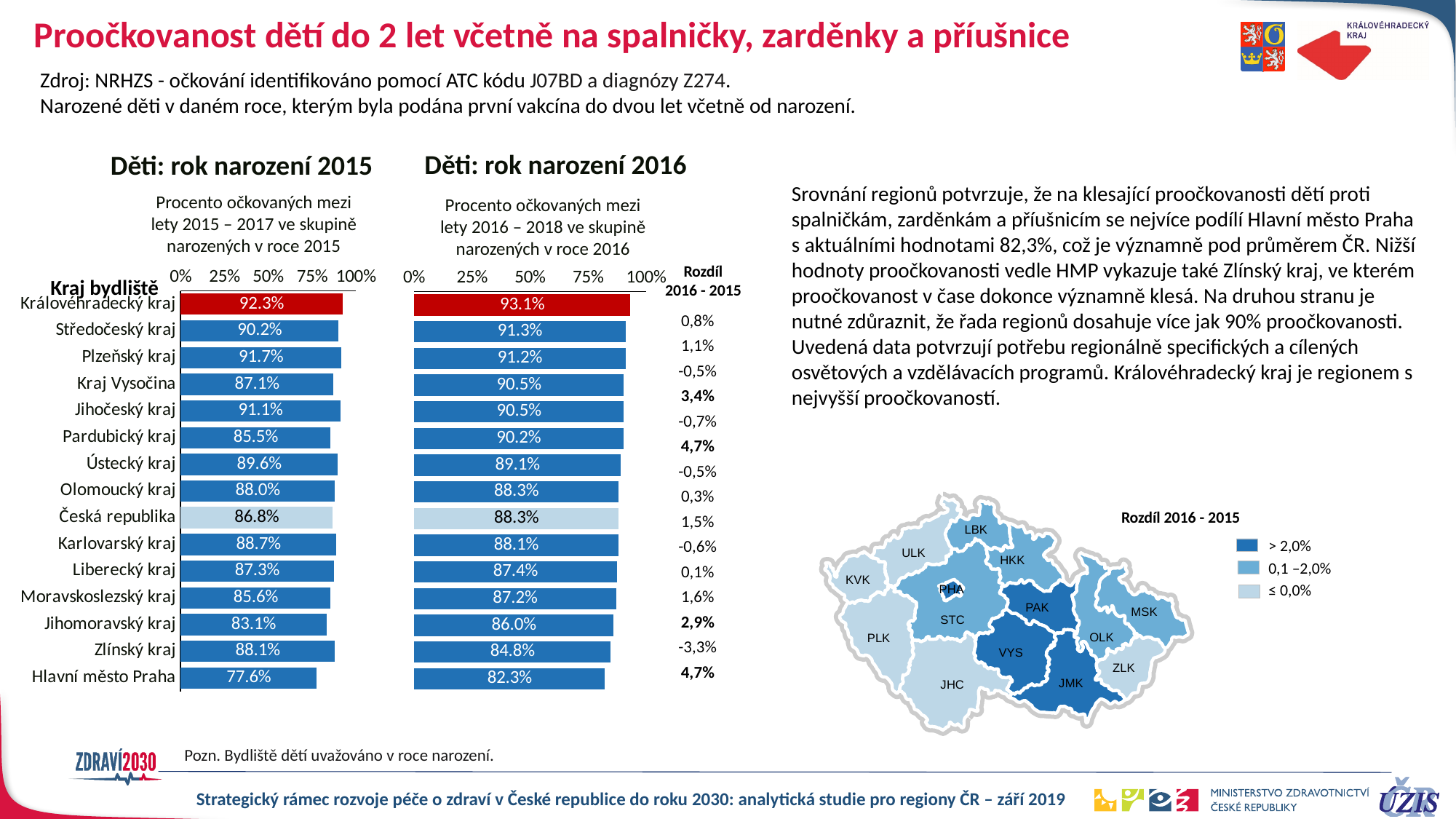
What kind of chart is used for 'Děti: rok narození 2015'? bar chart In the 'Děti: rok narození 2016' chart, which region has the lowest value? Hlavní město Praha In the 'Děti: rok narození 2016' chart, what is the value for Zlínský kraj? 84.8% In the 'Děti: rok narození 2015' chart, what is the difference between Královéhradecký kraj and Hlavní město Praha? 14.7 percentage points In the 'Děti: rok narození 2016' chart, what is the value for Hlavní město Praha? 82.3% In the 'Děti: rok narození 2015' chart, which region has the highest value? Královéhradecký kraj In the 'Děti: rok narození 2015' chart, is the value for Jihomoravský kraj greater or less than 75%? greater In the 'Děti: rok narození 2015' chart, what colour is the bar for Královéhradecký kraj? red In the 'Děti: rok narození 2015' chart, which region has the lowest value? Hlavní město Praha In the 'Děti: rok narození 2015' chart, what is the value for Královéhradecký kraj? 92.3% In the 'Děti: rok narození 2015' chart, which is larger: Plzeňský kraj or Středočeský kraj? Plzeňský kraj How many regions (categories) are shown in the 'Děti: rok narození 2016' chart? 15